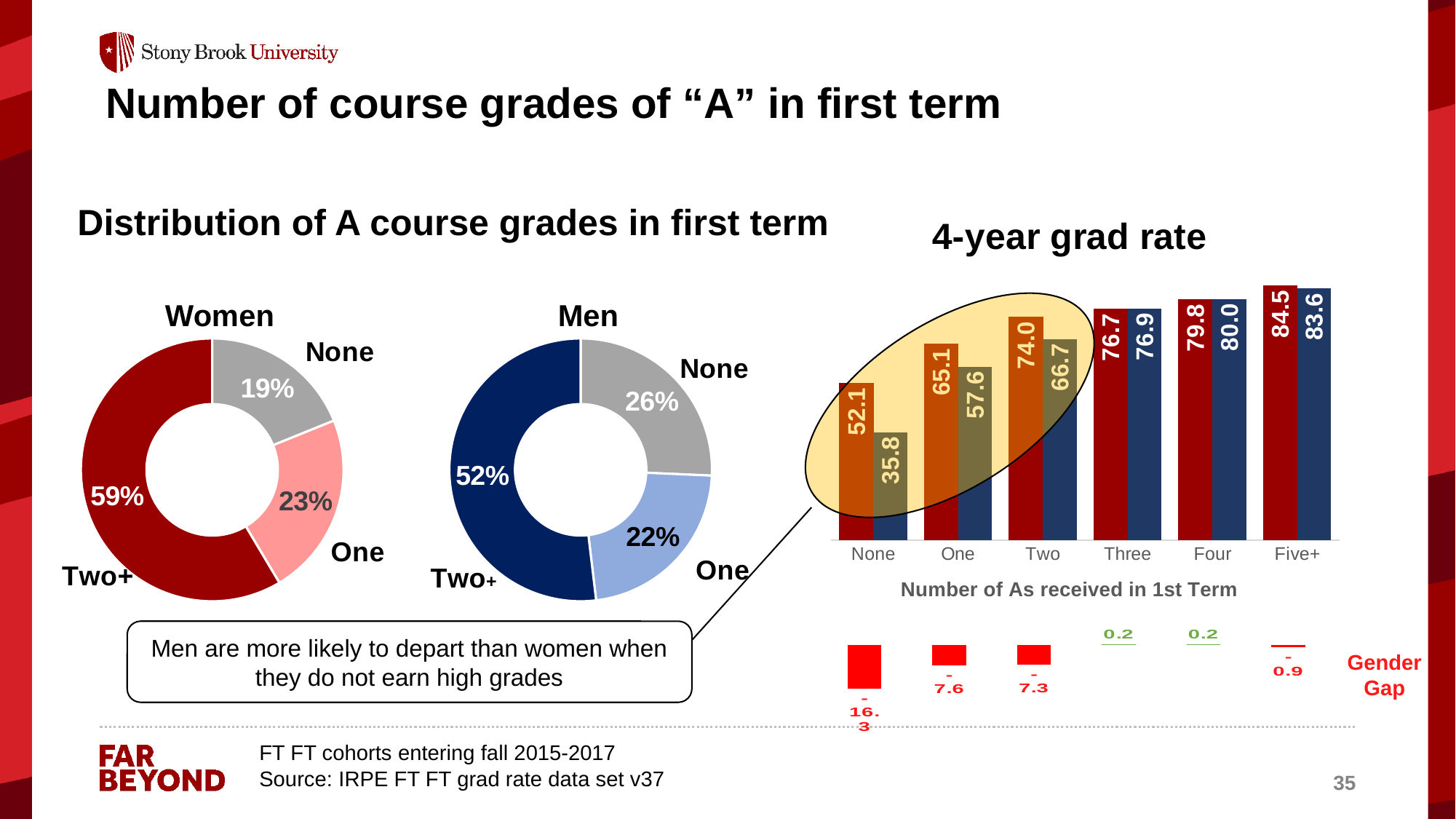
In the 4-year grad rate bar chart, what is the value of the red bar for None? 52.1 In the Men donut chart, what share of men received Two+ A grades? 52% What kind of chart is used to show the distribution of A course grades for Women? Donut (pie) chart In the 4-year grad rate bar chart, what is the value of the blue bar for Two? 66.7 In the 4-year grad rate bar chart, do the blue bar values rise or fall as the number of As increases from None to Five+? Rise What is the difference between the Two+ share in the Women donut chart and the Two+ share in the Men donut chart? 7 percentage points How many categories are shown on the x axis of the 4-year grad rate bar chart? 6 In the Men donut chart, which category has the smallest share? One In the Women donut chart, what share of women received no A grades (None)? 19% In the 4-year grad rate bar chart, what is the difference between the red bar and the blue bar for None? 16.3 In the Women donut chart, which category has the largest share? Two+ Comparing the two donut charts, is the share for None larger for Women or for Men? Men